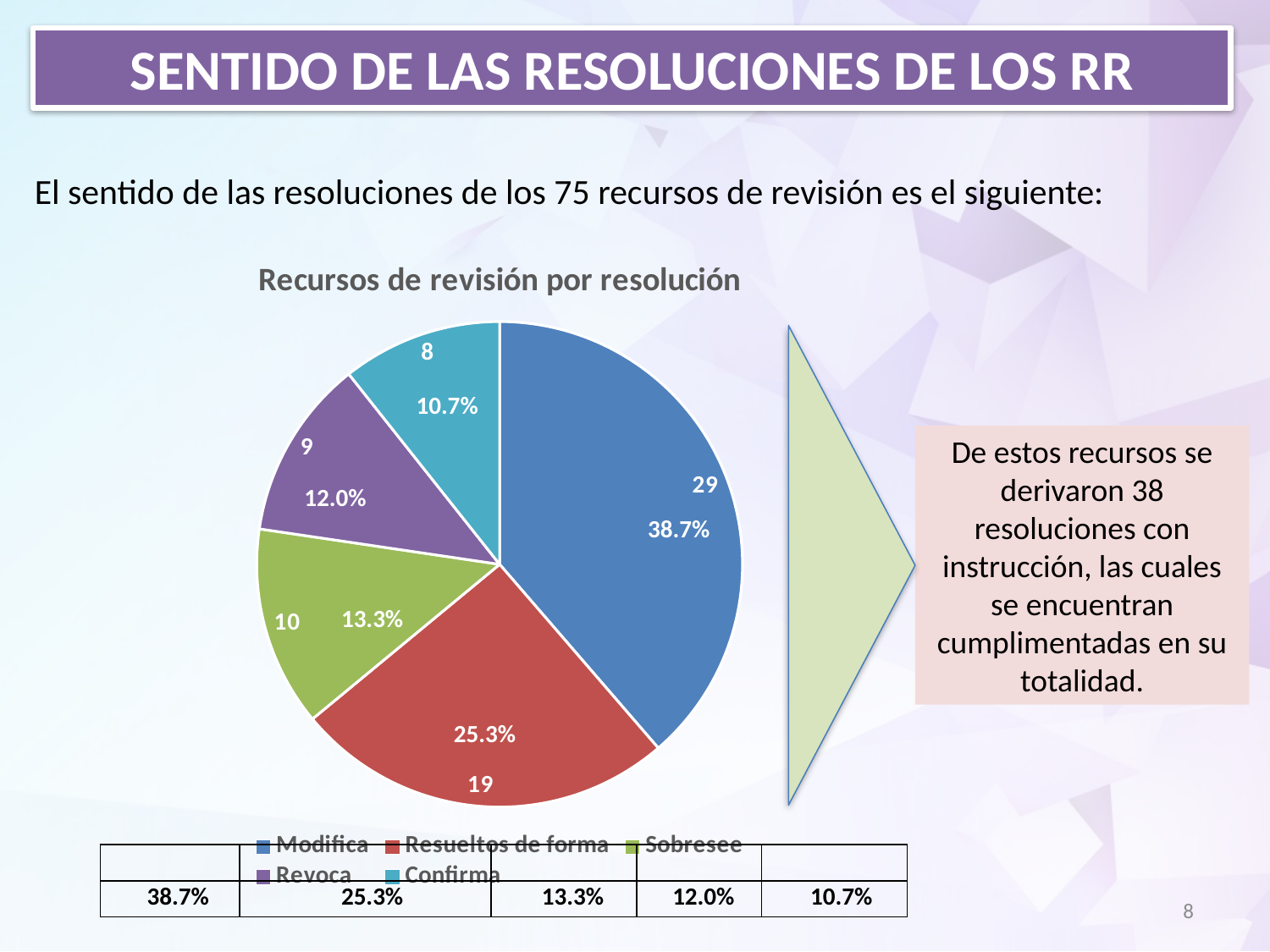
Which category has the smallest slice? Confirma What is the title of the chart? Recursos de revisión por resolución What is the value for Confirma? 8 What is the value for Modifica? 29 How many slices does the pie chart have? 5 Which category has the largest slice? Modifica What is the difference between the values for Modifica and Resueltos de forma? 10 What kind of chart is shown on the slide? pie chart How many entries does the chart legend list? 5 What share of the pie does Sobresee represent? 13.3% What share of the pie does Revoca represent? 12.0% What is the value for Resueltos de forma? 19